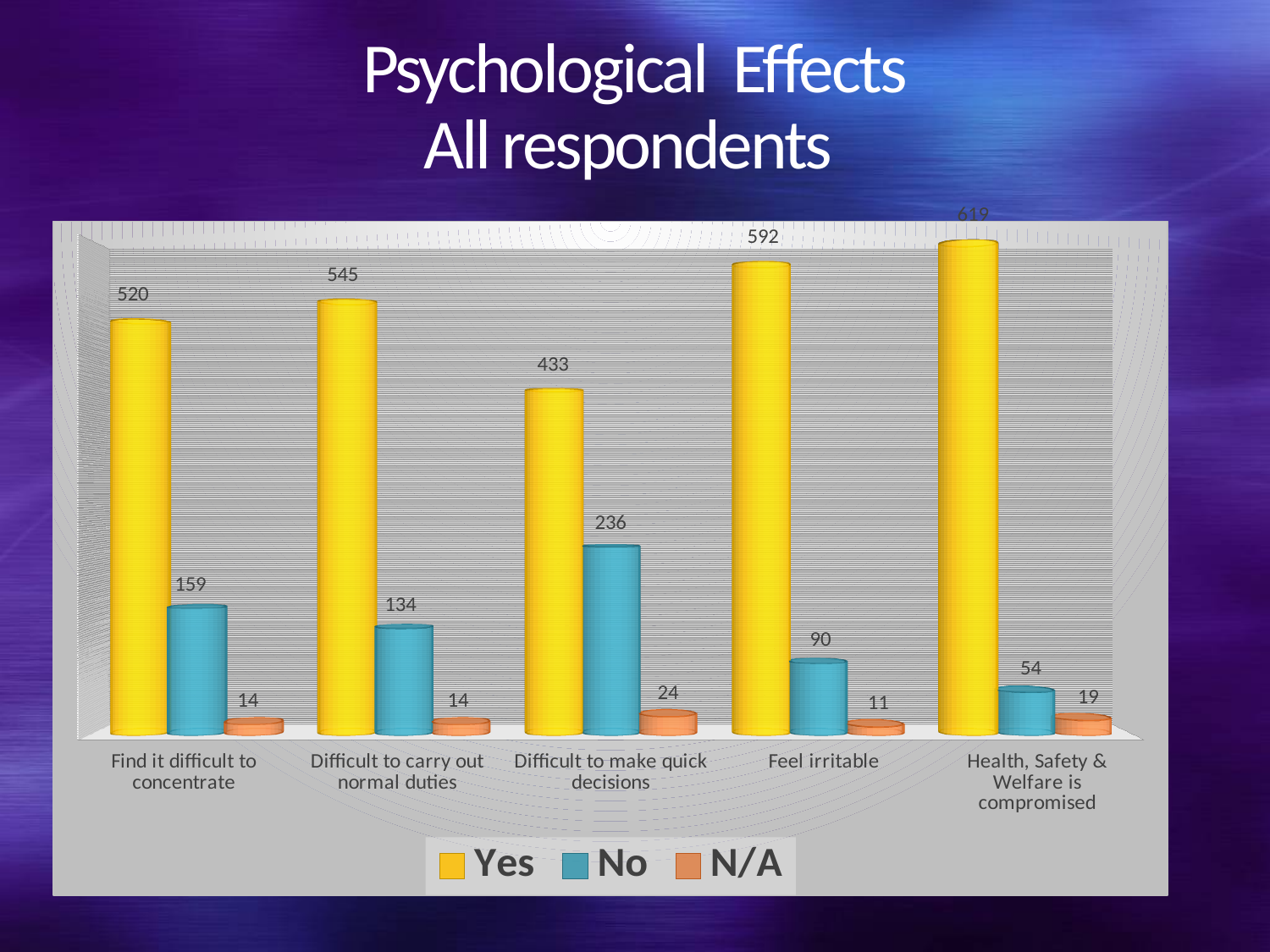
What kind of chart is shown on the slide? Bar chart Which category has the highest 'Yes' value? Health, Safety & Welfare is compromised Which is larger: the 'No' value for 'Find it difficult to concentrate' or the 'No' value for 'Difficult to carry out normal duties'? Find it difficult to concentrate What is the 'Yes' value for 'Feel irritable'? 592 What is the difference between the 'Yes' and 'No' values for 'Difficult to carry out normal duties'? 411 What is the 'No' value for 'Difficult to make quick decisions'? 236 What is the total of the 'Yes', 'No' and 'N/A' values for 'Feel irritable'? 693 What is the title of the chart? Psychological Effects All respondents How many categories are shown on the x axis? 5 How many series does the legend list? 3 What is the 'N/A' value for 'Health, Safety & Welfare is compromised'? 19 Which category has the lowest 'No' value? Health, Safety & Welfare is compromised